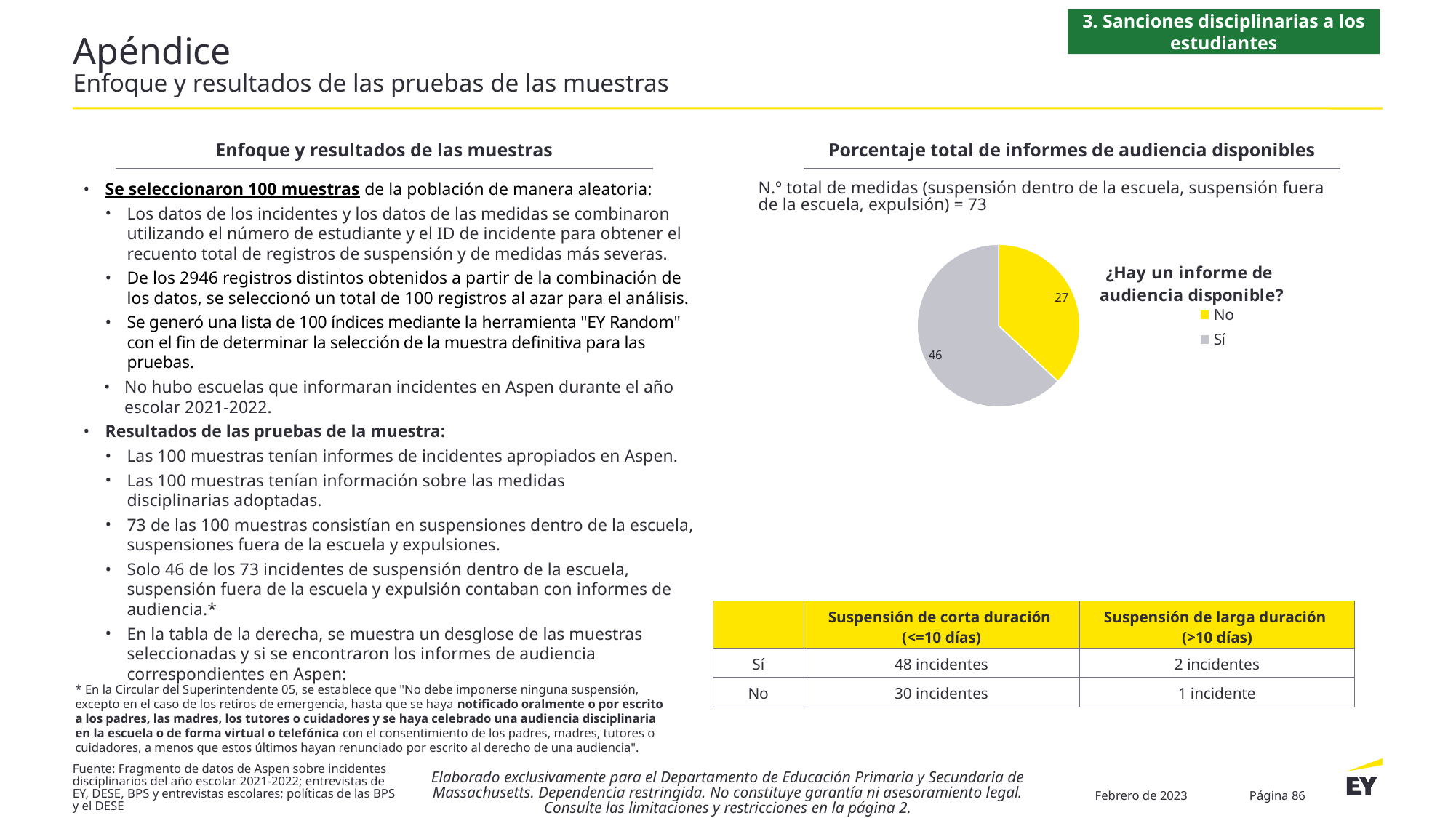
What is the difference between the "Sí" and "No" values in the pie chart? 19 Which colour represents "No" in the pie chart? Yellow What share of the pie chart does the "Sí" slice represent? 63% How many slices does the pie chart have? 2 What is the total of the two values shown in the pie chart? 73 Which slice of the pie chart is the smallest? No In the pie chart, what is the value for "No"? 27 Which slice of the pie chart is the largest? Sí How many entries does the pie chart legend list? 2 In the pie chart, what is the value for "Sí"? 46 What kind of chart is shown on the slide? Pie chart Which is larger in the pie chart, "Sí" or "No"? Sí